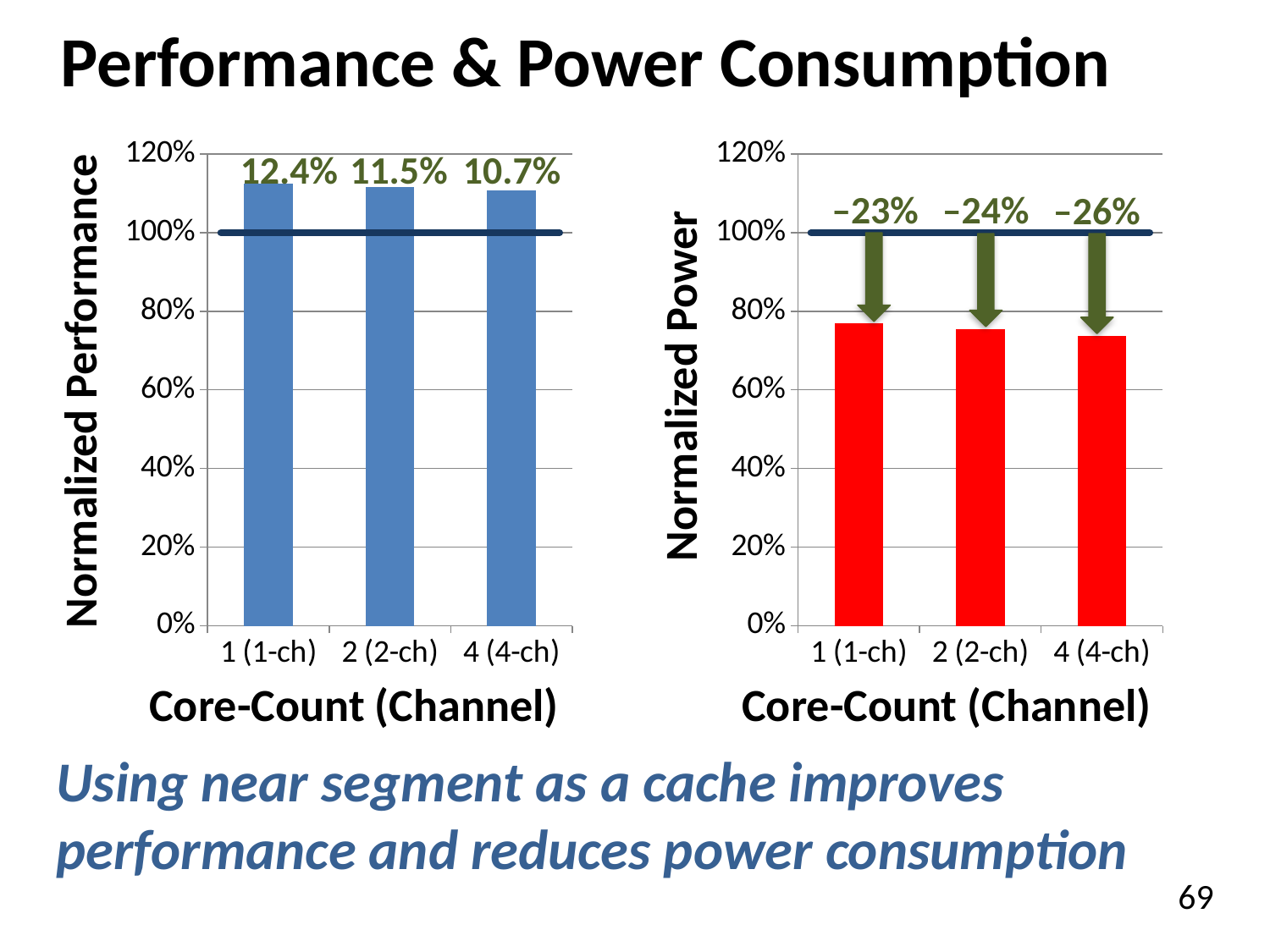
In the Normalized Performance chart, is the value for 2 (2-ch) greater or less than 100%? greater In the Normalized Power chart, what percentage reduction is labeled above the 4 (4-ch) bar? –26% In the Normalized Power chart, is the value for 4 (4-ch) greater or less than 80%? less In the Normalized Performance chart, do the labeled improvements rise or fall as core-count increases from 1 (1-ch) to 4 (4-ch)? fall In the Normalized Performance chart, what percentage improvement is labeled above the 2 (2-ch) bar? 11.5% How many core-count categories are shown on the x axis of the Normalized Performance chart? 3 In the Normalized Performance chart, what percentage improvement is labeled above the 1 (1-ch) bar? 12.4% What is the x-axis title of the Normalized Power chart? Core-Count (Channel) In the Normalized Performance chart, what percentage improvement is labeled above the 4 (4-ch) bar? 10.7% In the Normalized Power chart, what percentage reduction is labeled above the 1 (1-ch) bar? –23% What kind of chart is the Normalized Performance chart on the left? bar chart In the Normalized Power chart, which core-count category has the lowest normalized power? 4 (4-ch)